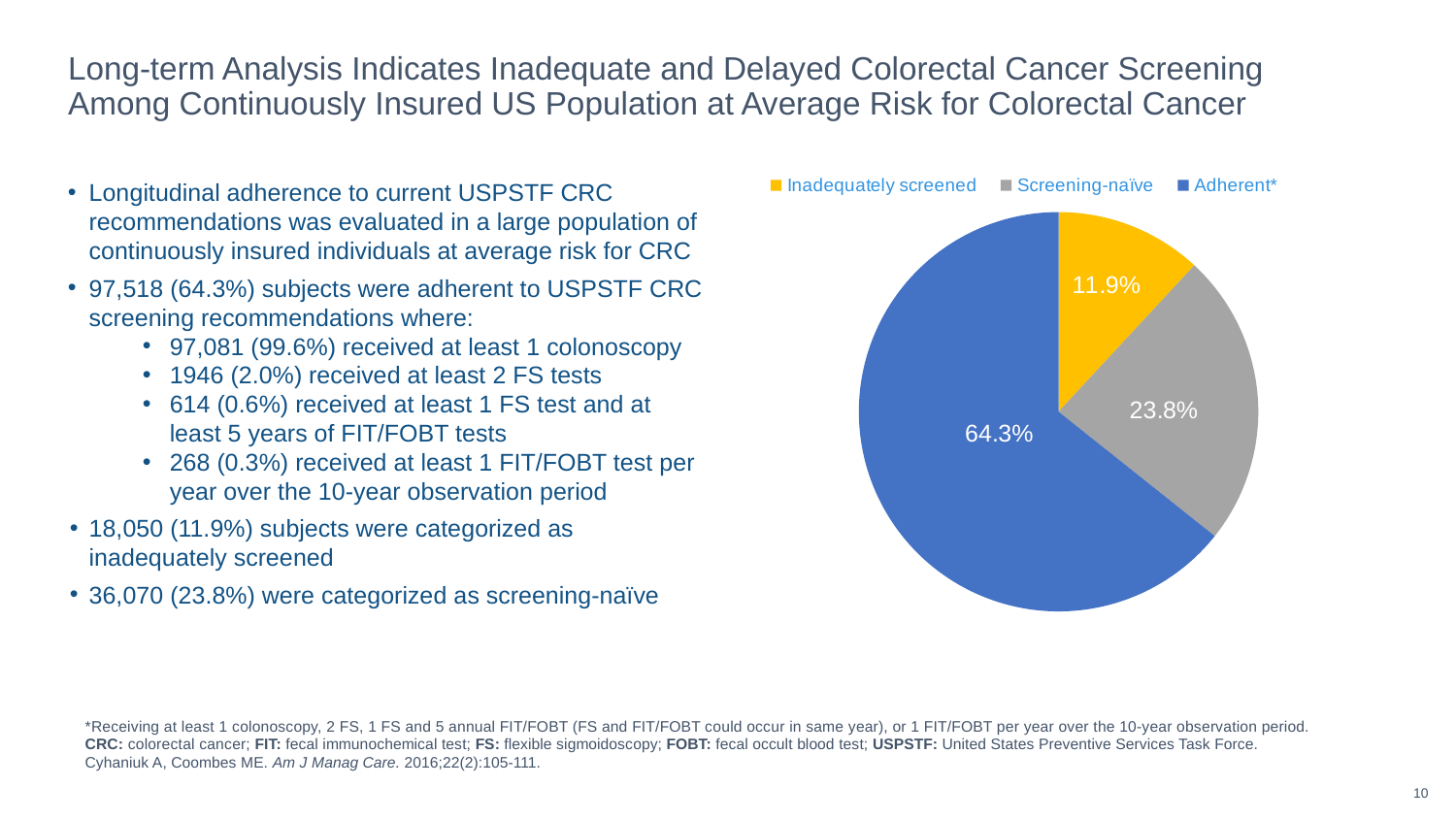
Which category has the smallest share of the pie? Inadequately screened What is the difference in percentage points between the Adherent* and Screening-naïve slices? 40.5 How many slices does the pie chart have? 3 What colour is the Adherent* slice in the pie chart? blue What percentage is shown for the Inadequately screened slice? 11.9% What percentage is shown for the Screening-naïve slice? 23.8% What kind of chart is shown on the slide? pie chart How many entries does the legend list? 3 Which category has the largest share of the pie? Adherent* What is the difference in percentage points between the Screening-naïve and Inadequately screened slices? 11.9 What percentage of the pie is labelled for the Adherent* slice? 64.3% Which is larger, the Screening-naïve slice or the Inadequately screened slice? Screening-naïve